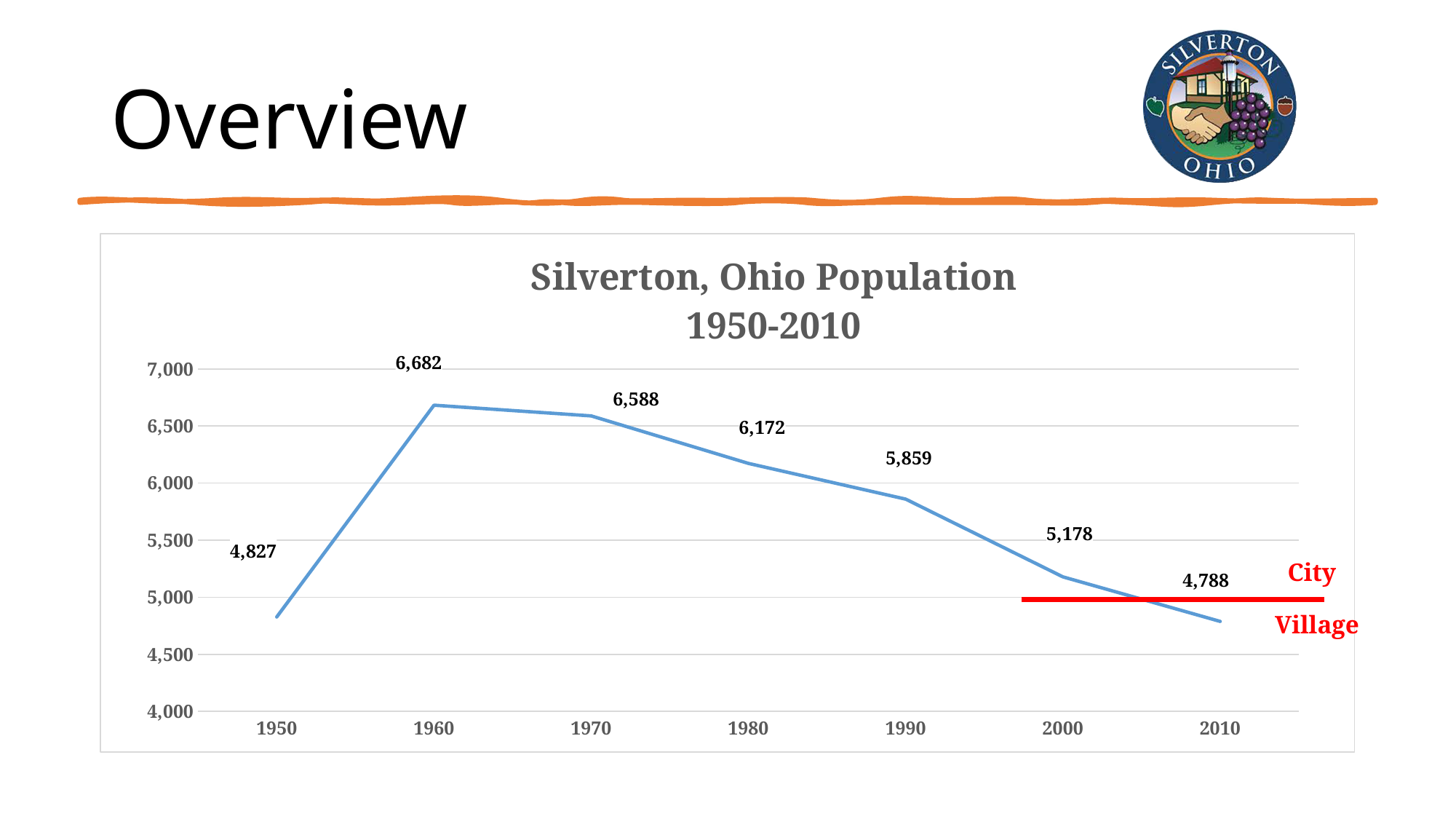
What was the population of Silverton, Ohio in 2010? 4,788 What is the title of the chart? Silverton, Ohio Population 1950-2010 In which year was Silverton's population lowest? 2010 What was the population of Silverton, Ohio in 1990? 5,859 What was the population of Silverton, Ohio in 1960? 6,682 By how much did Silverton's population fall between 1960 and 2010? 1,894 Which year had a larger population, 1950 or 2000? 2000 Is the population value for 1980 greater or less than 6,000? greater How many years (data points) are plotted on the chart? 7 What kind of chart is shown on the slide? line chart What is the difference between the 1950 and 2000 population values? 351 In which year was Silverton's population highest? 1960